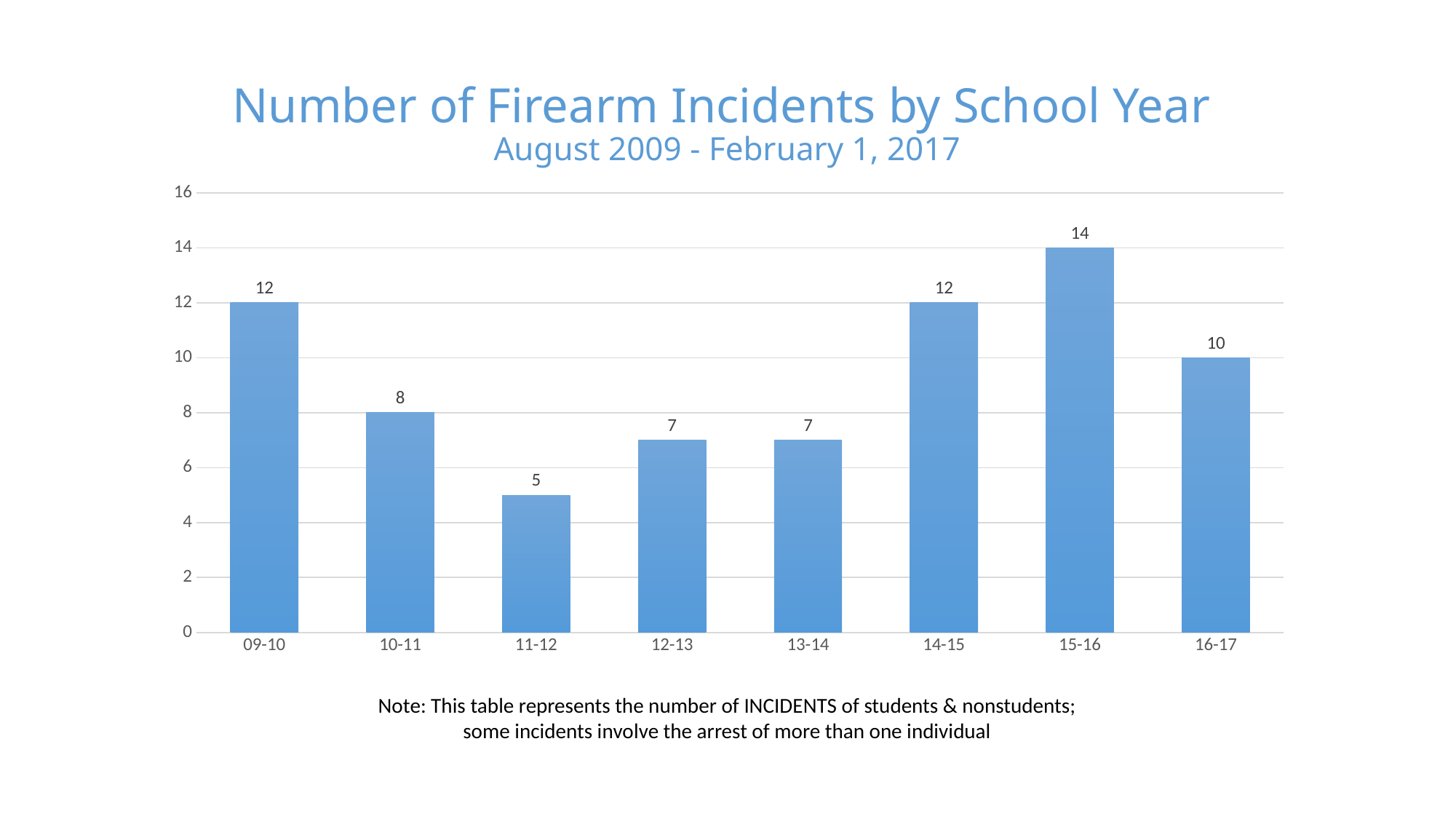
Which school year has the lowest number of firearm incidents? 11-12 Which school year had more firearm incidents, 10-11 or 14-15? 14-15 What is the title of the chart? Number of Firearm Incidents by School Year What is the number of firearm incidents for the 11-12 school year? 5 What is the difference in firearm incidents between the 15-16 and 11-12 school years? 9 Which school year has the highest number of firearm incidents? 15-16 Is the value for 13-14 greater or less than 8? less What is the number of firearm incidents for the 16-17 school year? 10 What date range does the chart subtitle give? August 2009 - February 1, 2017 How many school years are shown on the chart? 8 What kind of chart is shown on the slide? Bar chart Do the values rise or fall from the 11-12 school year to the 15-16 school year? Rise